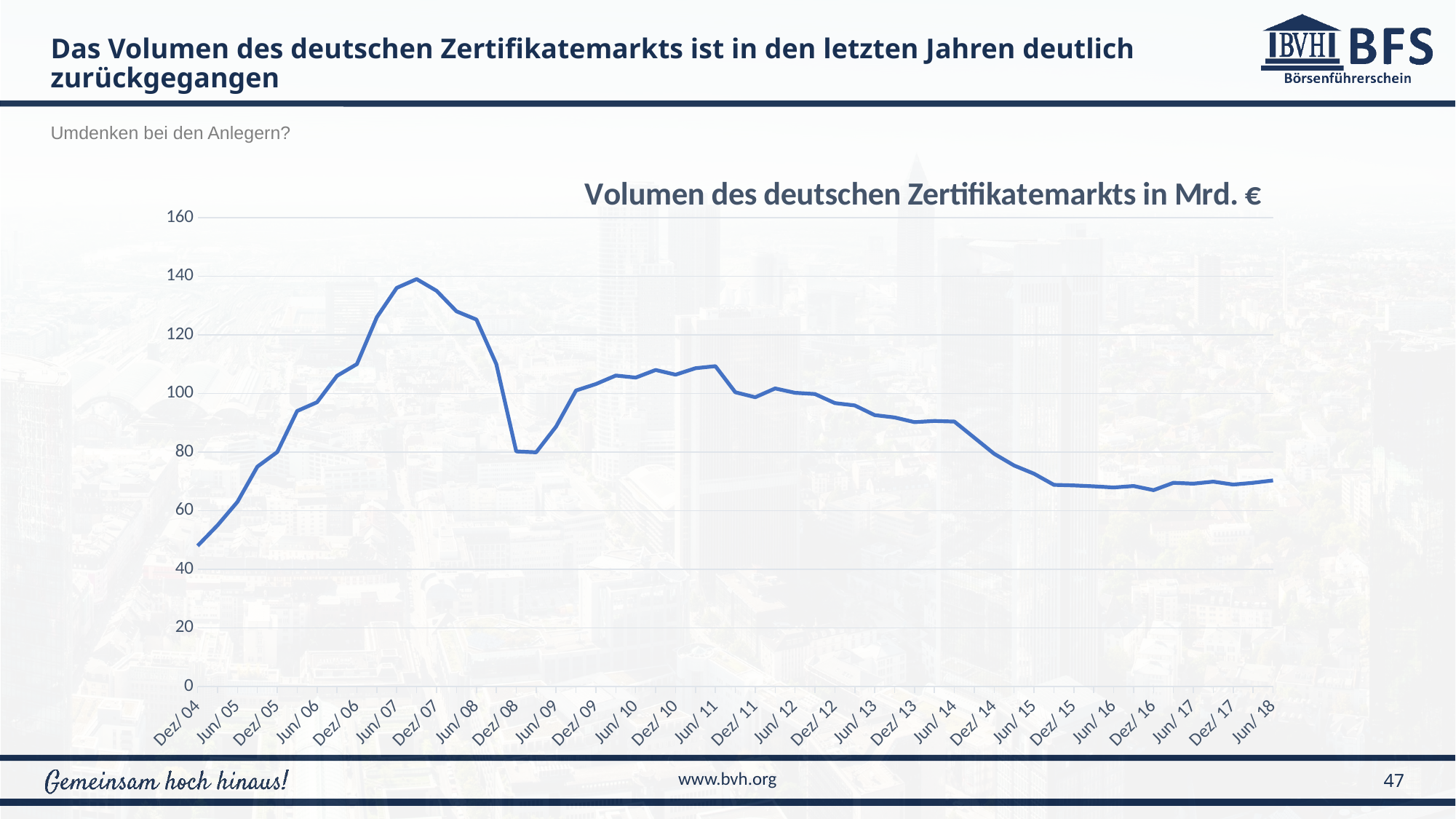
What kind of chart is shown on the slide? line chart Is the value at Dez/ 04 greater or less than 60? less Does the line rise or fall between Dez/ 11 and Dez/ 15? fall How many labels are shown on the x axis? 28 Is the value at Dez/ 07 greater or less than 120? greater Is the value at Jun/ 11 greater or less than 100? greater At which x-axis label does the line have its lowest value? Dez/ 04 What is the title of the chart? Volumen des deutschen Zertifikatemarkts in Mrd. € Which is larger, the value at Dez/ 07 or the value at Jun/ 18? Dez/ 07 Which is larger, the value at Dez/ 04 or the value at Jun/ 18? Jun/ 18